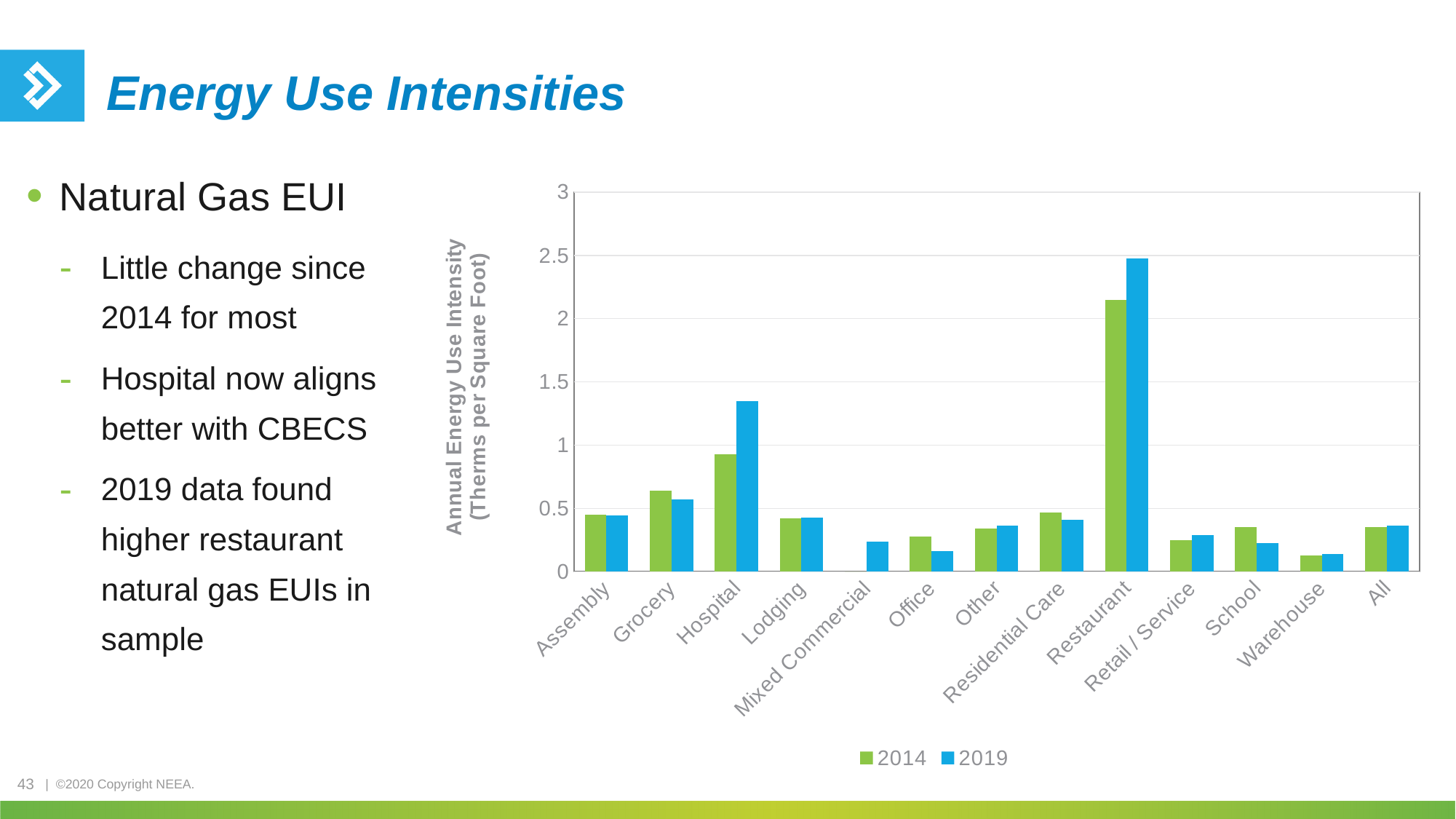
Is the 2019 value for Hospital greater or less than 1? greater For Hospital, which series has the larger value, 2014 or 2019? 2019 How many series does the chart legend list? 2 Which category has the highest 2014 value in the chart? Restaurant Is the 2014 value for Hospital greater or less than 1? less Is the 2019 value for Restaurant greater or less than 2? greater For Office, which series has the larger value, 2014 or 2019? 2014 What kind of chart is shown on the slide? Bar chart What is the y-axis title of the chart? Annual Energy Use Intensity (Therms per Square Foot) How many building-type categories are shown on the x axis of the chart? 13 Which category has the highest 2019 value in the chart? Restaurant Which category has the lowest 2014 value among those with a 2014 bar? Warehouse